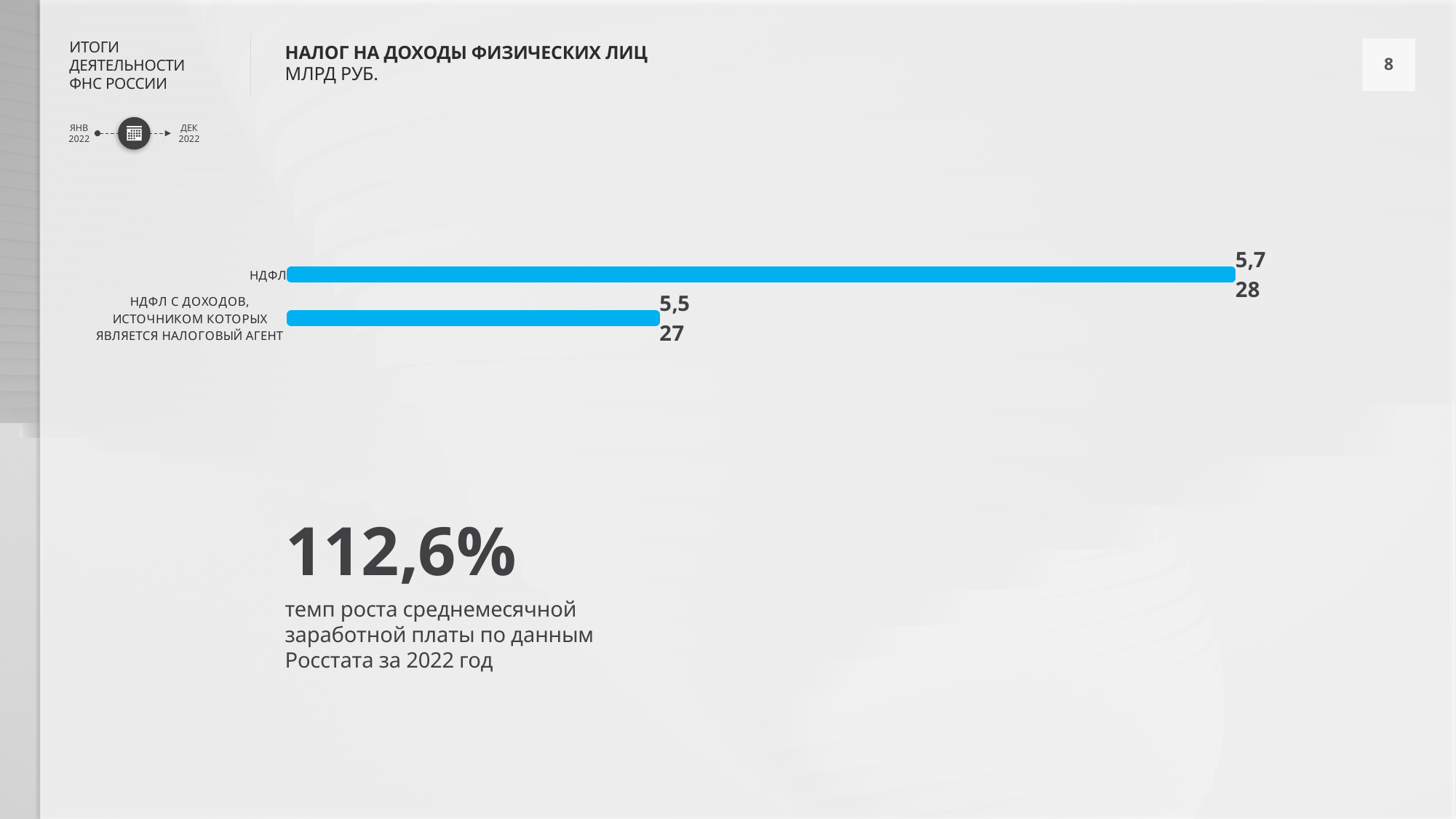
In what units are the chart values given? МЛРД РУБ. What is the difference between the value for НДФЛ and the value for НДФЛ с доходов, источником которых является налоговый агент? 201 Which category has the highest value in the chart? НДФЛ What is the value shown for НДФЛ? 5,728 What kind of chart is shown on the slide? bar chart What is the title of the chart? НАЛОГ НА ДОХОДЫ ФИЗИЧЕСКИХ ЛИЦ What is the value shown for НДФЛ с доходов, источником которых является налоговый агент? 5,527 Which category has the larger value, НДФЛ or НДФЛ с доходов, источником которых является налоговый агент? НДФЛ How many categories does the chart show? 2 Which category has the lowest value in the chart? НДФЛ с доходов, источником которых является налоговый агент